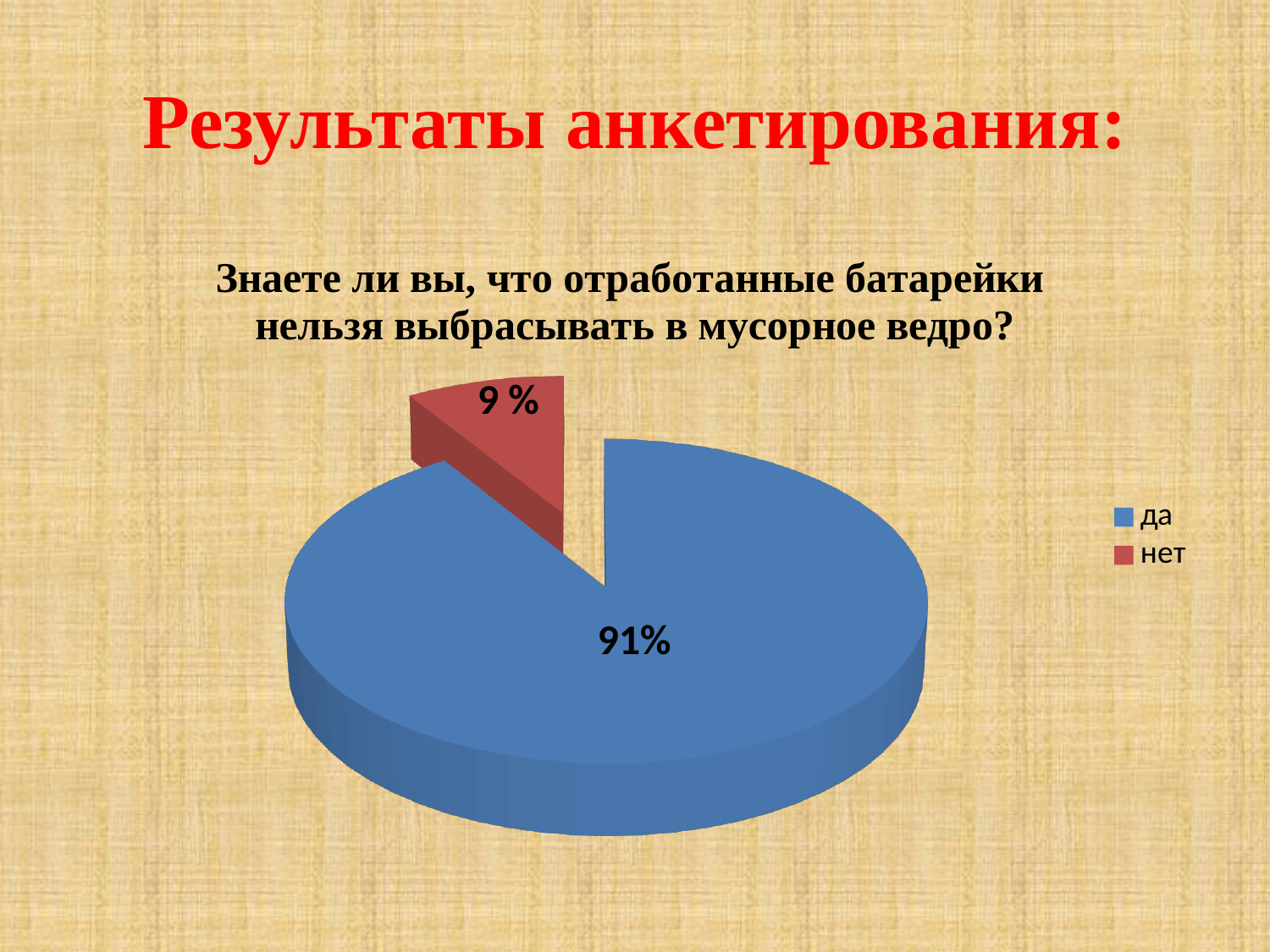
What share of the pie does the "нет" slice represent? 9 % What colour is the "да" slice? blue How many slices does the pie chart have? 2 How many entries does the legend list? 2 Which is larger, the "да" slice or the "нет" slice? да What share of the pie does the "да" slice represent? 91% What is the difference in percentage points between the "да" and "нет" slices? 82 What question is the pie chart titled with? Знаете ли вы, что отработанные батарейки нельзя выбрасывать в мусорное ведро? Which slice is the smallest in the pie chart? нет Which slice is the largest in the pie chart? да What kind of chart is shown on the slide? pie chart